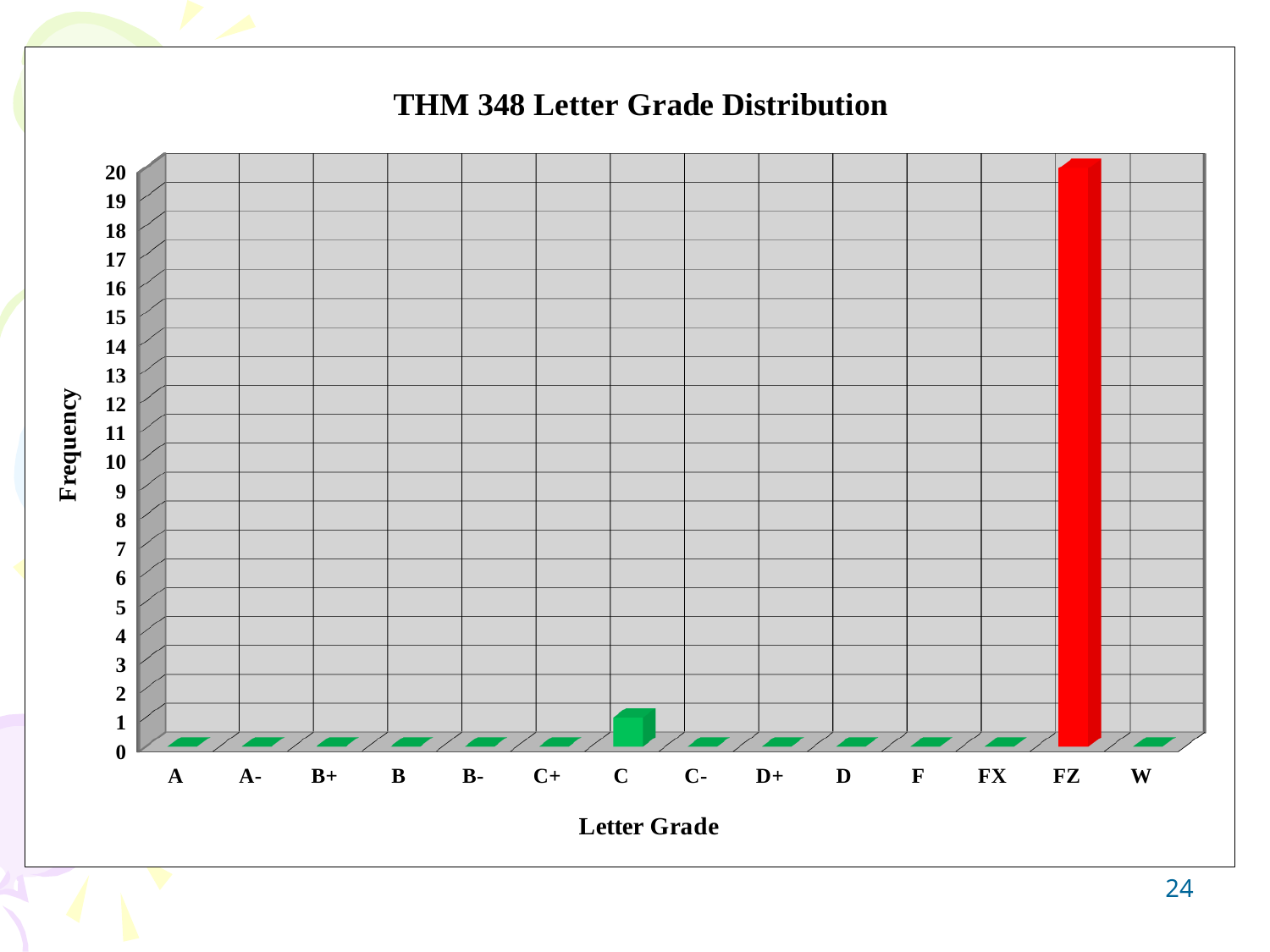
What is the difference between the frequency for FZ and the frequency for C? 19 Which is larger, the frequency for C or the frequency for FZ? FZ What is the frequency for the C grade? 1 Is the frequency for FZ greater or less than 10? greater How many letter grade categories are shown on the x axis? 14 What is the frequency for the FZ grade? 20 What is the frequency for the A grade? 0 What is the frequency for the W grade? 0 What is the label of the y axis? Frequency Which letter grade has the highest frequency? FZ What is the title of the chart? THM 348 Letter Grade Distribution What kind of chart is shown on the slide? bar chart